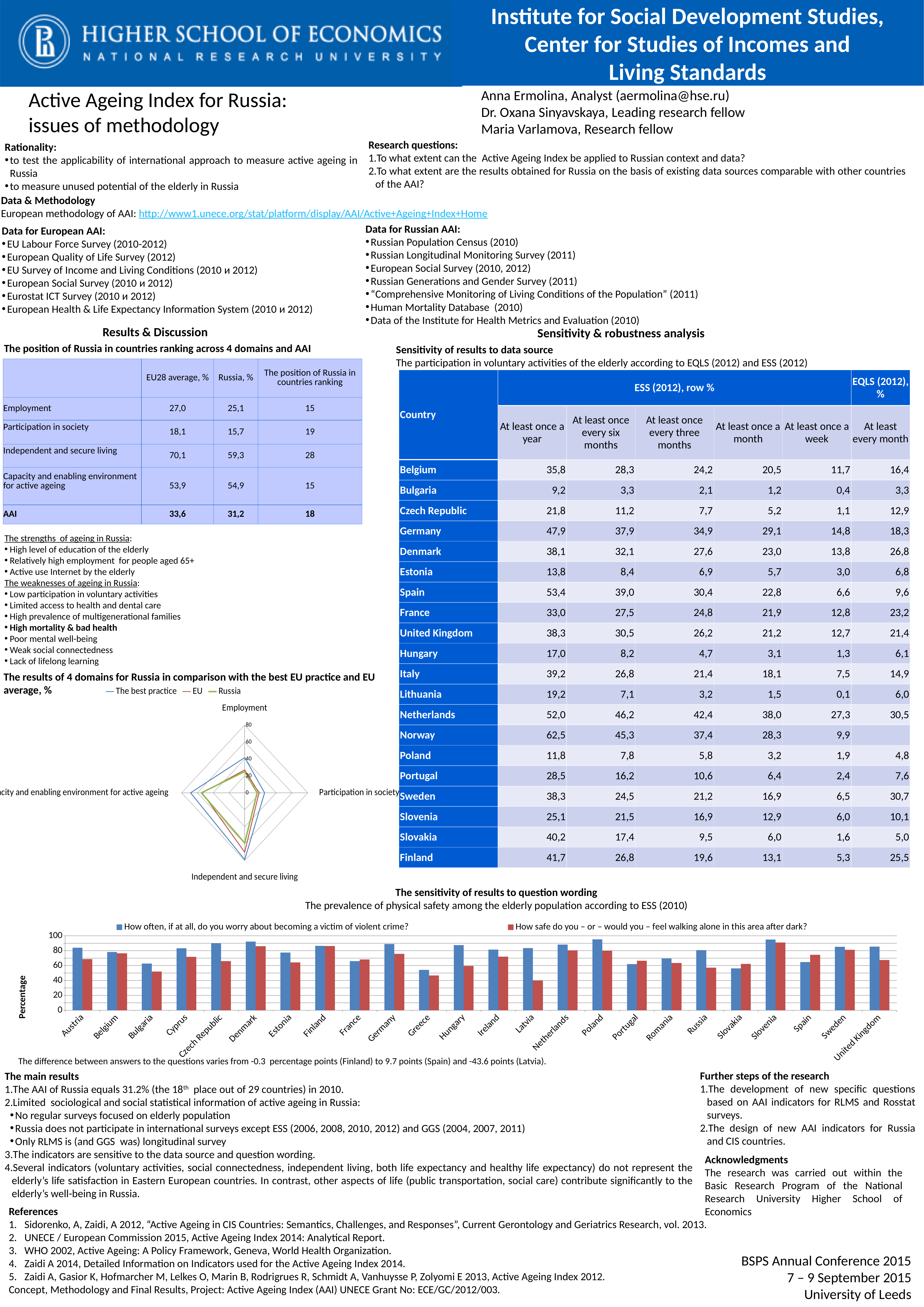
How many countries are shown on the bar chart "The prevalence of physical safety among the elderly population according to ESS (2010)"? 24 On the radar chart "The results of 4 domains for Russia...", which series has the highest value for Independent and secure living? The best practice On the bar chart "The prevalence of physical safety among the elderly population...", for Latvia, which series has the larger value: "How often, if at all, do you worry about becoming a victim of violent crime?" or "How safe do you – or – would you – feel walking alone in this area after dark?"? How often, if at all, do you worry about becoming a victim of violent crime? How many domains (axes) are plotted on the radar chart "The results of 4 domains for Russia..."? 4 On the bar chart "The prevalence of physical safety among the elderly population...", which country has the lowest value for "How safe do you – or – would you – feel walking alone in this area after dark?"? Latvia How many series does the legend of the bar chart "The prevalence of physical safety among the elderly population..." list? 2 What kind of chart is "The results of 4 domains for Russia in comparison with the best EU practice and EU average, %"? Radar chart On the bar chart "The prevalence of physical safety among the elderly population...", is the value for Poland on "How often, if at all, do you worry about becoming a victim of violent crime?" greater or less than 80? greater How many series does the legend of the radar chart "The results of 4 domains for Russia..." list? 3 On the radar chart "The results of 4 domains for Russia...", is the value of Russia for Employment greater or less than 40? less On the bar chart "The prevalence of physical safety among the elderly population...", which country has the highest value for "How safe do you – or – would you – feel walking alone in this area after dark?"? Slovenia What kind of chart is "The prevalence of physical safety among the elderly population according to ESS (2010)"? Bar chart